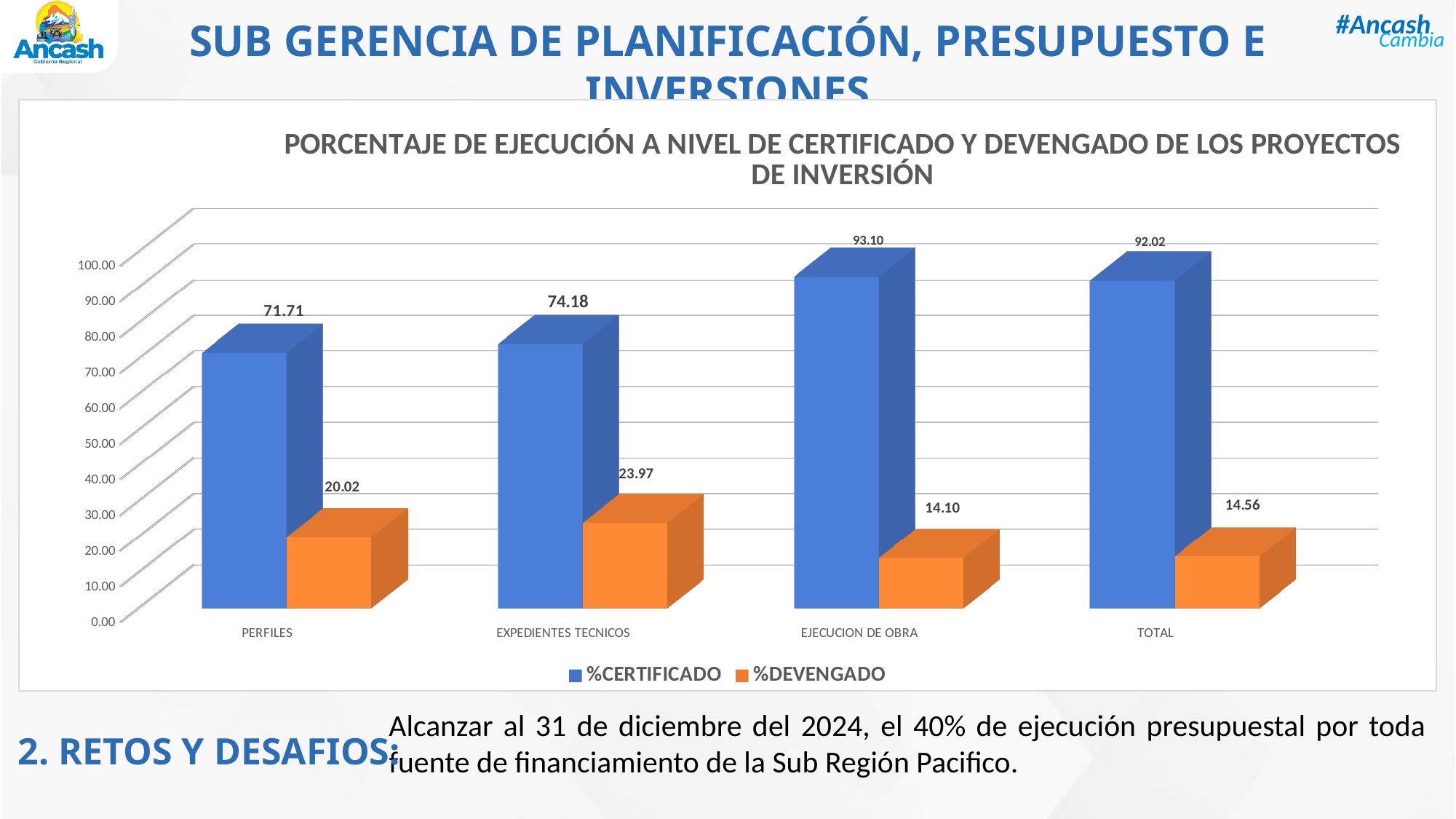
How many series does the legend list? 2 What is the %DEVENGADO value for PERFILES? 20.02 What is the difference between the %CERTIFICADO and %DEVENGADO values for TOTAL? 77.46 Which colour represents the %DEVENGADO series? Orange What kind of chart is shown on the slide? Bar chart What is the %CERTIFICADO value for TOTAL? 92.02 What is the %DEVENGADO value for EXPEDIENTES TECNICOS? 23.97 Which category has the highest %CERTIFICADO value? EJECUCION DE OBRA How many categories are shown on the x axis? 4 Which is larger, the %CERTIFICADO value for PERFILES or for EXPEDIENTES TECNICOS? EXPEDIENTES TECNICOS What is the %CERTIFICADO value for EJECUCION DE OBRA? 93.10 Which category has the lowest %DEVENGADO value? EJECUCION DE OBRA